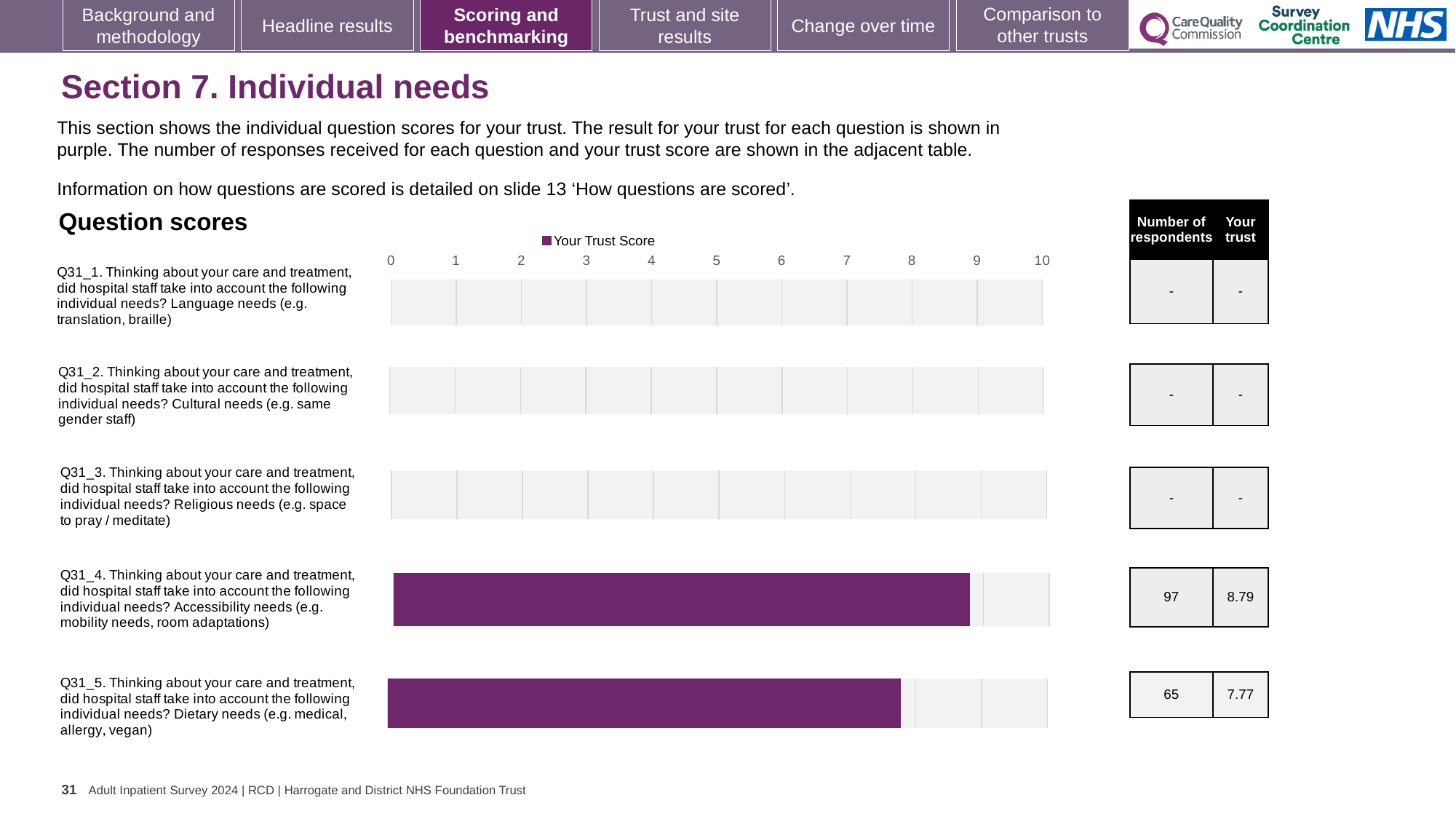
What is the trust score for Q31_4 (Accessibility needs)? 8.79 What is the maximum value shown on the chart's axis? 10 Is the trust score for Q31_4 (Accessibility needs) greater or less than 8? greater How many series does the chart legend list? 1 How many respondents answered Q31_4 (Accessibility needs)? 97 Which question has the higher trust score, Q31_4 (Accessibility needs) or Q31_5 (Dietary needs)? Q31_4 (Accessibility needs) How many respondents answered Q31_5 (Dietary needs)? 65 Is the trust score for Q31_5 (Dietary needs) greater or less than 8? less What is the difference between the trust scores for Q31_4 (Accessibility needs) and Q31_5 (Dietary needs)? 1.02 What is the trust score for Q31_5 (Dietary needs)? 7.77 How many questions are listed in the Question scores chart? 5 What type of chart is used to show the question scores? Bar chart